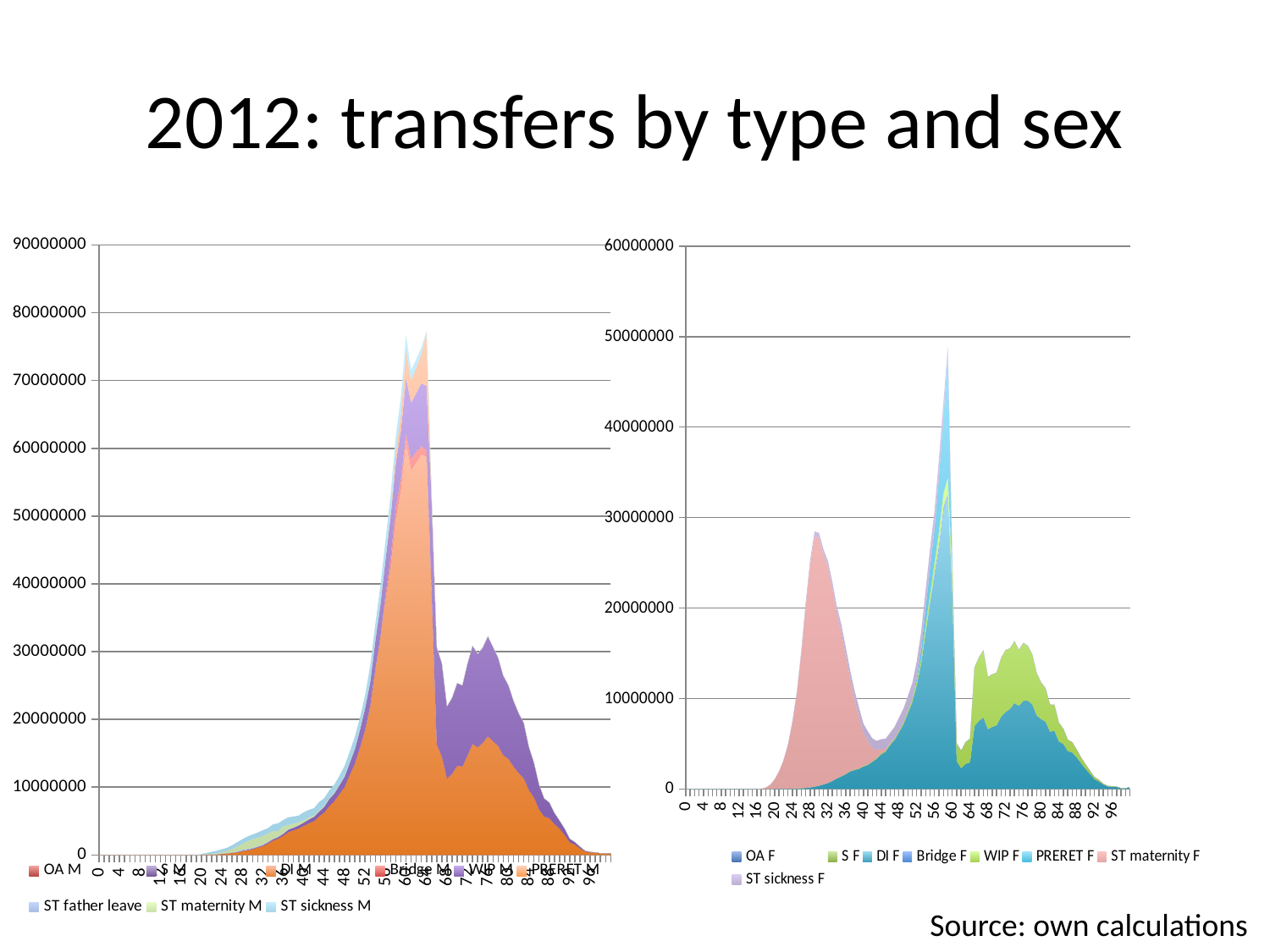
What kind of chart is the right chart on the slide? stacked area chart In the right chart, is the peak total value around age 60 greater or less than 40000000? greater In the right chart, is the total value at age 96 greater or less than 10000000? less In the left chart, is the total value at age 20 greater or less than 10000000? less What kind of chart is the left chart on the slide? stacked area chart How many series does the legend of the right chart list? 8 In the left chart, do the total values rise or fall along the x axis from age 80 to age 96? fall What is the highest value shown on the y axis of the left chart? 90000000 What is the highest value shown on the y axis of the right chart? 60000000 How many series does the legend of the left chart list? 9